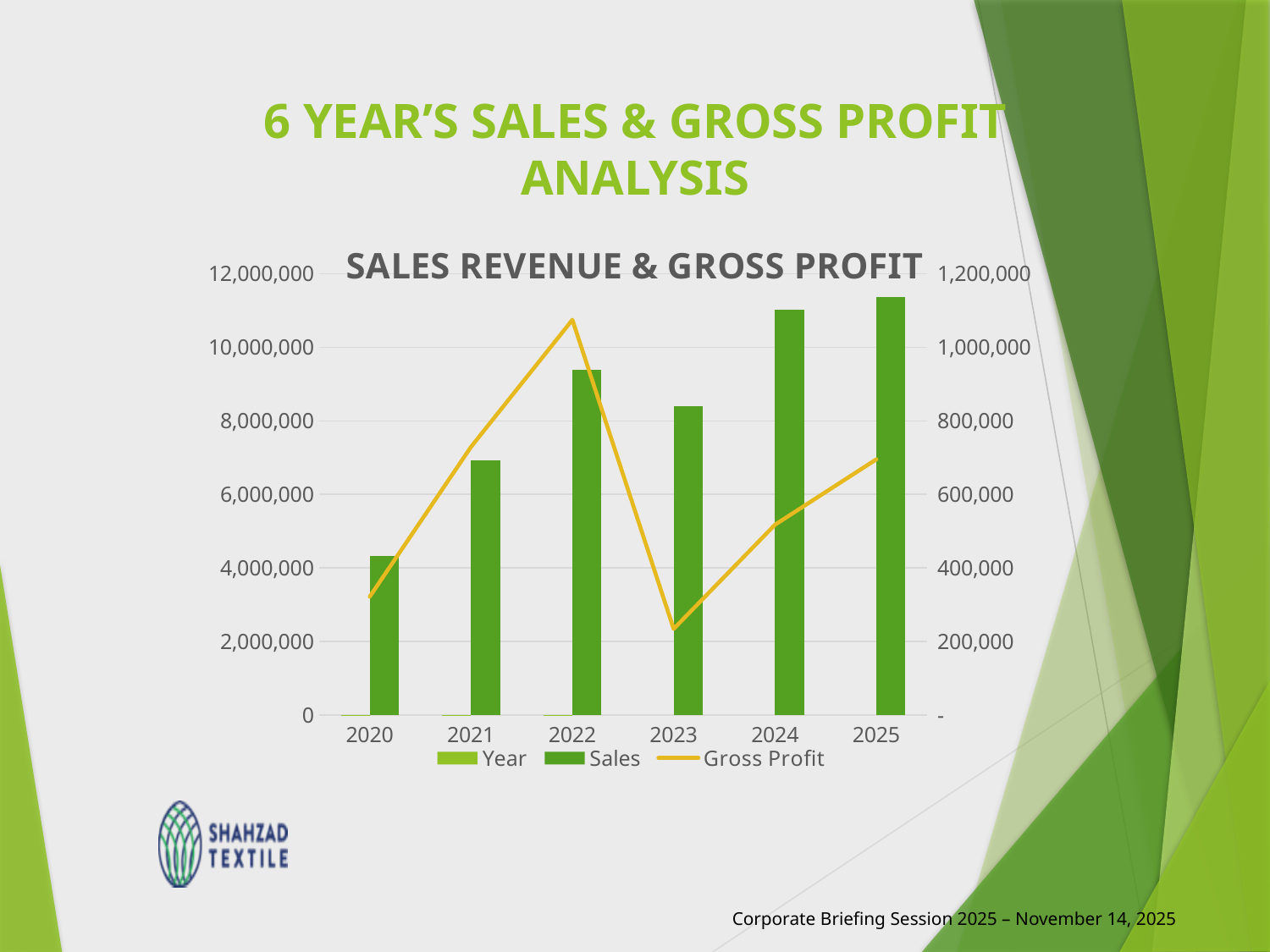
Which year has higher Sales, 2022 or 2023? 2022 In which year does the Gross Profit line reach its highest point? 2022 How many series does the legend of the SALES REVENUE & GROSS PROFIT chart list? 3 What kind of chart is the SALES REVENUE & GROSS PROFIT chart? A combination bar and line chart Is the Sales value for 2024 greater or less than 10,000,000? greater How many years are shown on the x axis of the SALES REVENUE & GROSS PROFIT chart? 6 Which year has the lowest Sales bar in the SALES REVENUE & GROSS PROFIT chart? 2020 Is the Gross Profit value for 2022 greater or less than 1,000,000? greater In which year does the Gross Profit line reach its lowest point? 2023 Do Sales rise or fall from 2020 to 2022? rise Is the Sales value for 2021 greater or less than 8,000,000? less